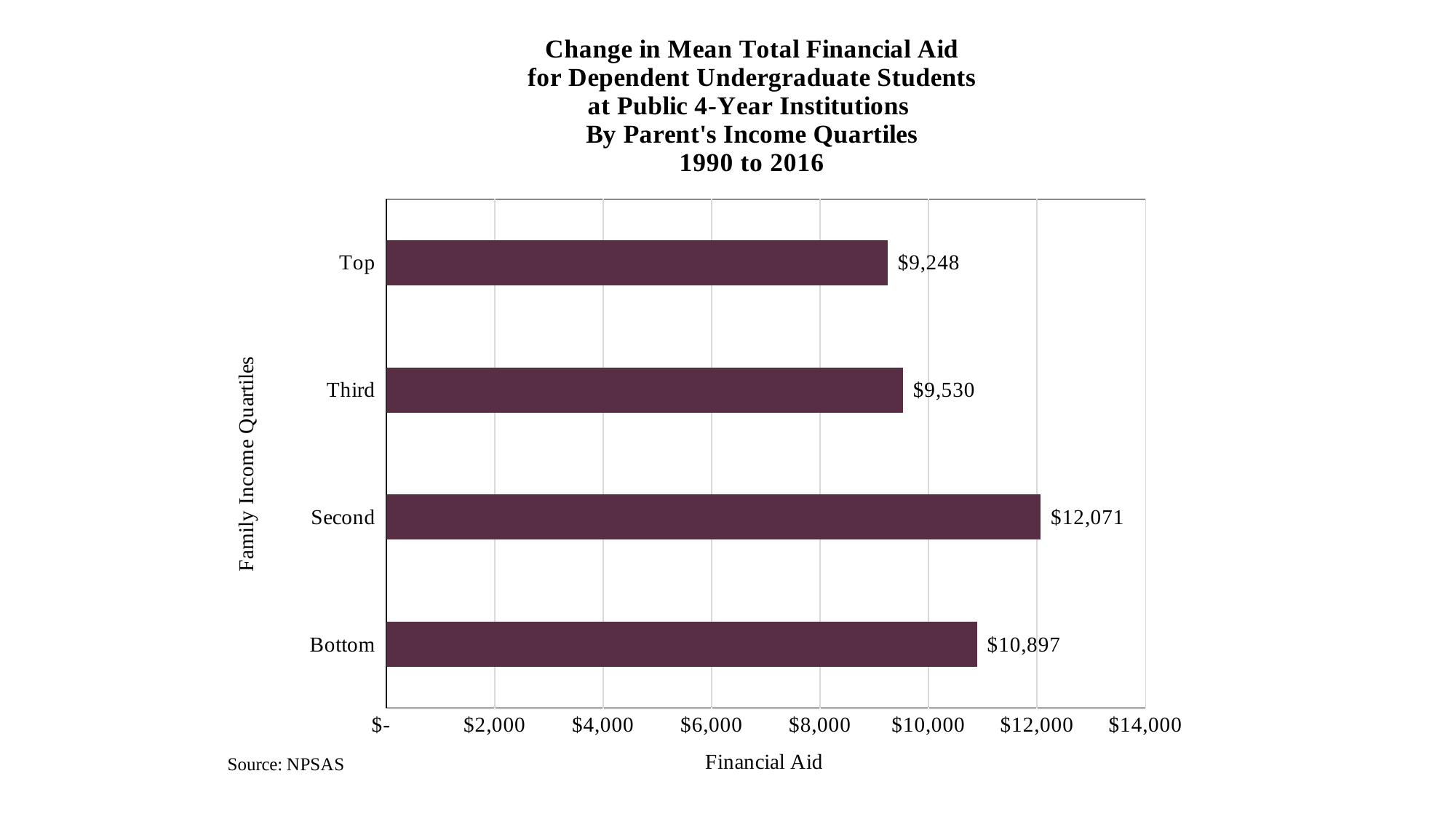
What is the difference between the Second and Bottom quartile values? $1,174 What kind of chart is shown on the slide? Bar chart What is the value for the Top quartile? $9,248 What is the value for the Bottom quartile? $10,897 What is the value for the Third quartile? $9,530 What is the label of the horizontal axis? Financial Aid What is the difference between the Third and Top quartile values? $282 Which quartile has the lowest value? Top Which quartile has the highest value? Second How many quartile categories are shown in the chart? 4 What is the value for the Second quartile? $12,071 Which is larger, the value for Bottom or the value for Third? Bottom